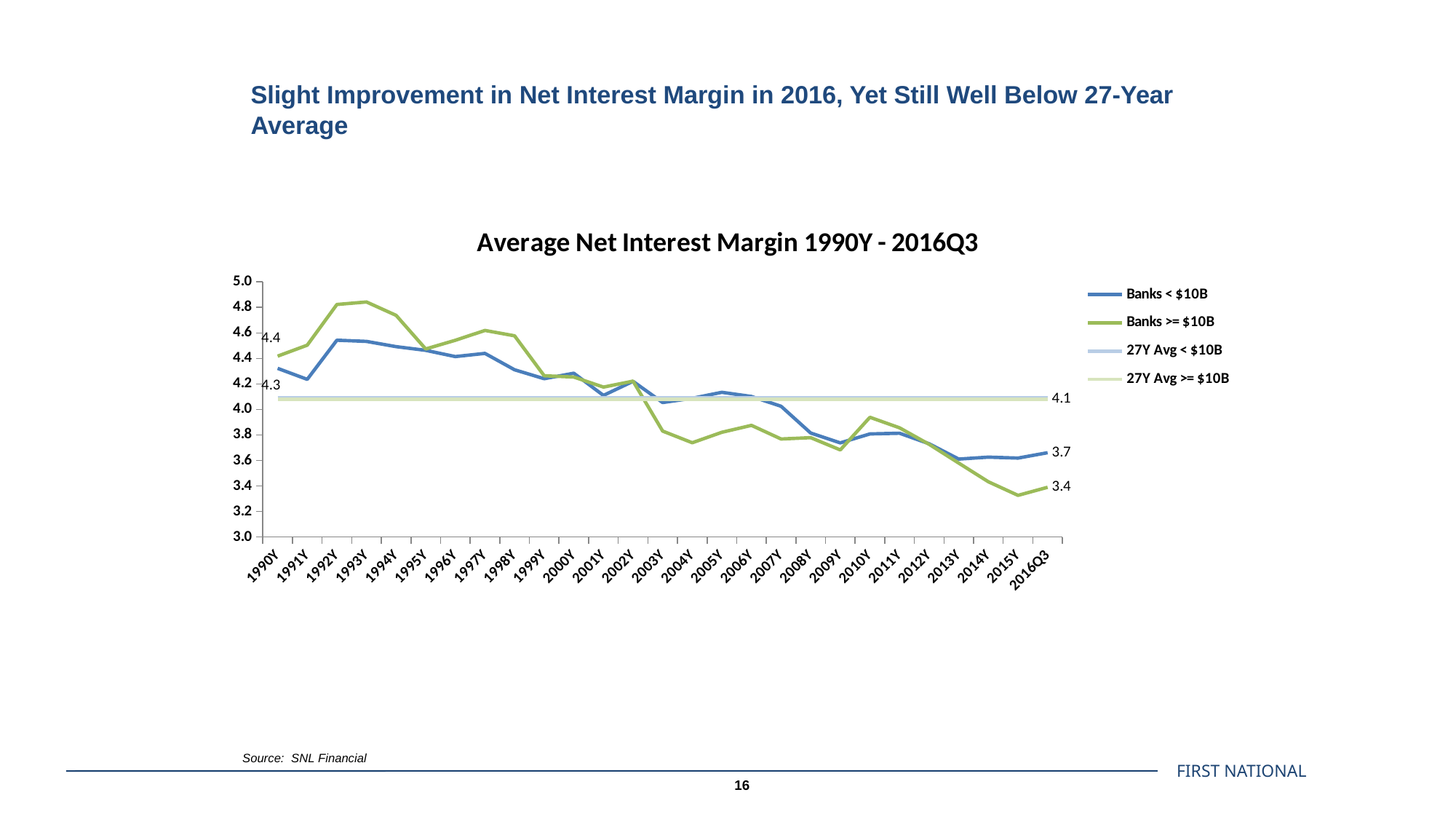
What is the value for Banks < $10B in 1990Y? 4.3 Is the value for Banks >= $10B in 1993Y greater or less than 4.6? greater What value is labelled on the 27-year average lines at the right of the chart? 4.1 How many time points are shown on the x axis of the chart? 27 What is the difference between the Banks < $10B and Banks >= $10B values at 2016Q3? 0.3 Do the values for Banks >= $10B rise or fall overall from 1990Y to 2016Q3? fall How many series does the legend of the chart list? 4 What is the value for Banks < $10B at 2016Q3? 3.7 What is the value for Banks >= $10B in 1990Y? 4.4 At 2016Q3, which series has the higher value, Banks < $10B or Banks >= $10B? Banks < $10B What is the value for Banks >= $10B at 2016Q3? 3.4 What kind of chart is shown on the slide? line chart